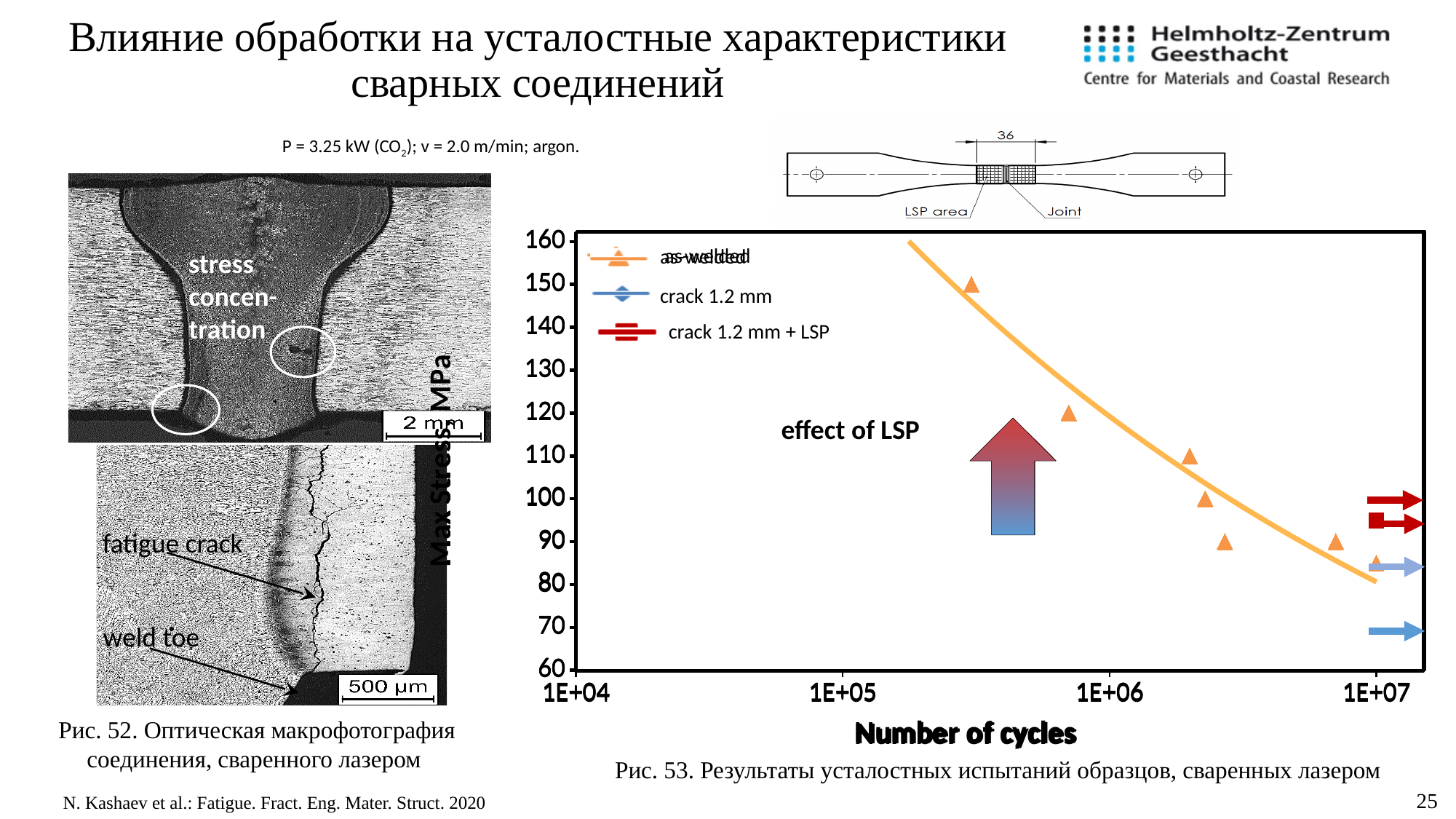
Is the second as-welded point from the left greater or less than 110 MPa? greater Are the red crack 1.2 mm + LSP arrows at the right edge of the chart greater or less than 90 MPa? greater Which is larger: the leftmost as-welded point or the rightmost as-welded point? the leftmost as-welded point What is the label of the x axis of the fatigue chart? Number of cycles Do the as-welded values rise or fall as the number of cycles increases? fall What kind of chart is shown in Рис. 53? scatter chart Are the blue crack 1.2 mm arrows at the right edge of the chart greater or less than 90 MPa? less What is the highest value shown on the y axis of the fatigue chart? 160 How many series does the legend of the fatigue chart list? 3 What are the three legend entries of the fatigue chart? as-welded, crack 1.2 mm, crack 1.2 mm + LSP